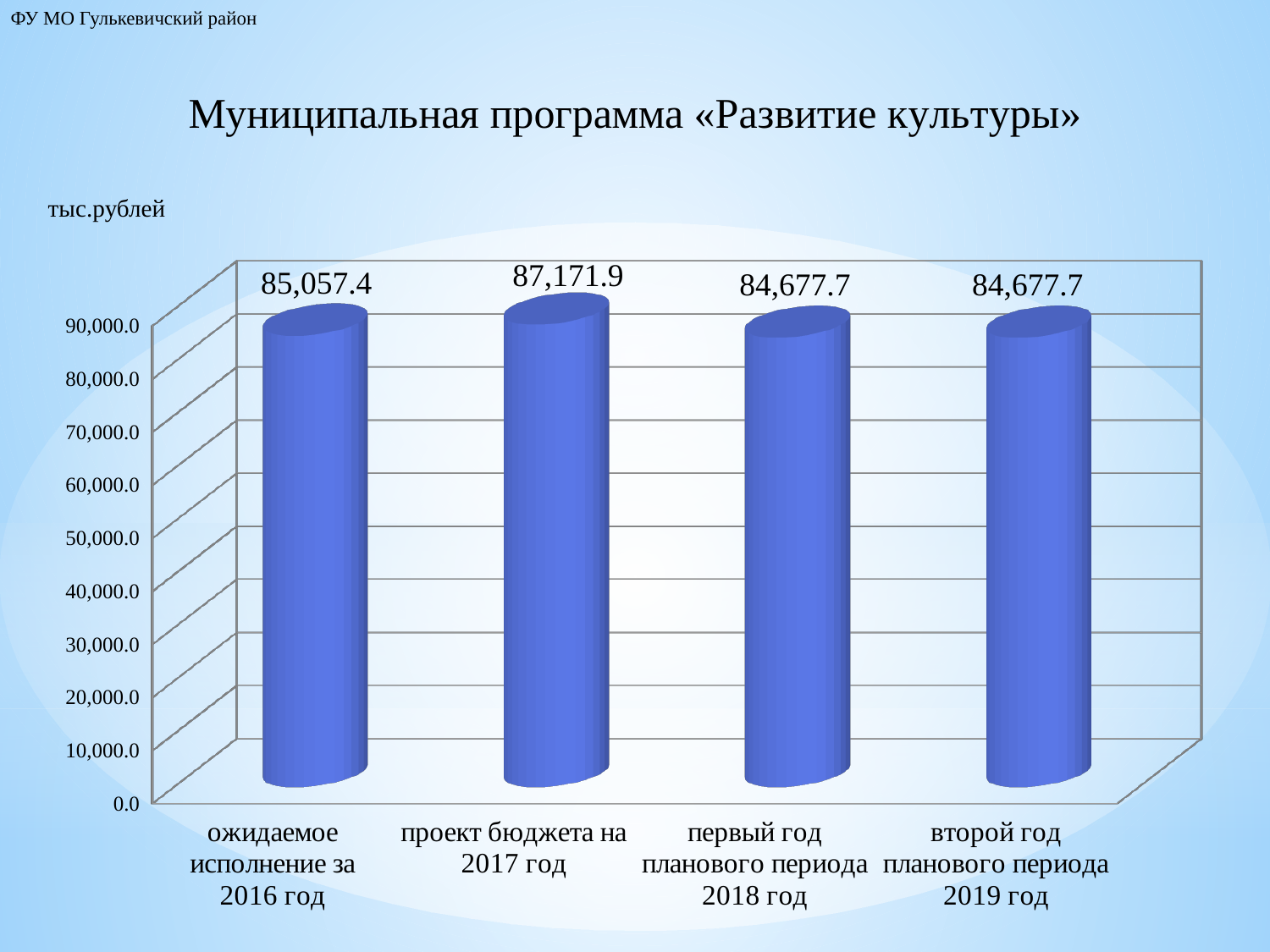
Do the values rise or fall from 2017 (проект бюджета) to 2018 (первый год планового периода)? fall Which category has the highest value? проект бюджета на 2017 год What is the value for «проект бюджета на 2017 год»? 87,171.9 How many categories are shown on the x axis? 4 What kind of chart is shown on the slide? bar chart What is the value for «ожидаемое исполнение за 2016 год»? 85,057.4 What unit of measurement is indicated above the chart? тыс.рублей Which is larger: the value for 2016 (ожидаемое исполнение) or the value for 2018 (первый год планового периода)? ожидаемое исполнение за 2016 год What is the value for «второй год планового периода 2019 год»? 84,677.7 Is the value for «первый год планового периода 2018 год» greater or less than 80,000.0? greater What is the difference between the value for 2017 (проект бюджета) and the value for 2018 (первый год планового периода)? 2,494.2 What is the difference between the value for 2017 (проект бюджета) and the value for 2016 (ожидаемое исполнение)? 2,114.5